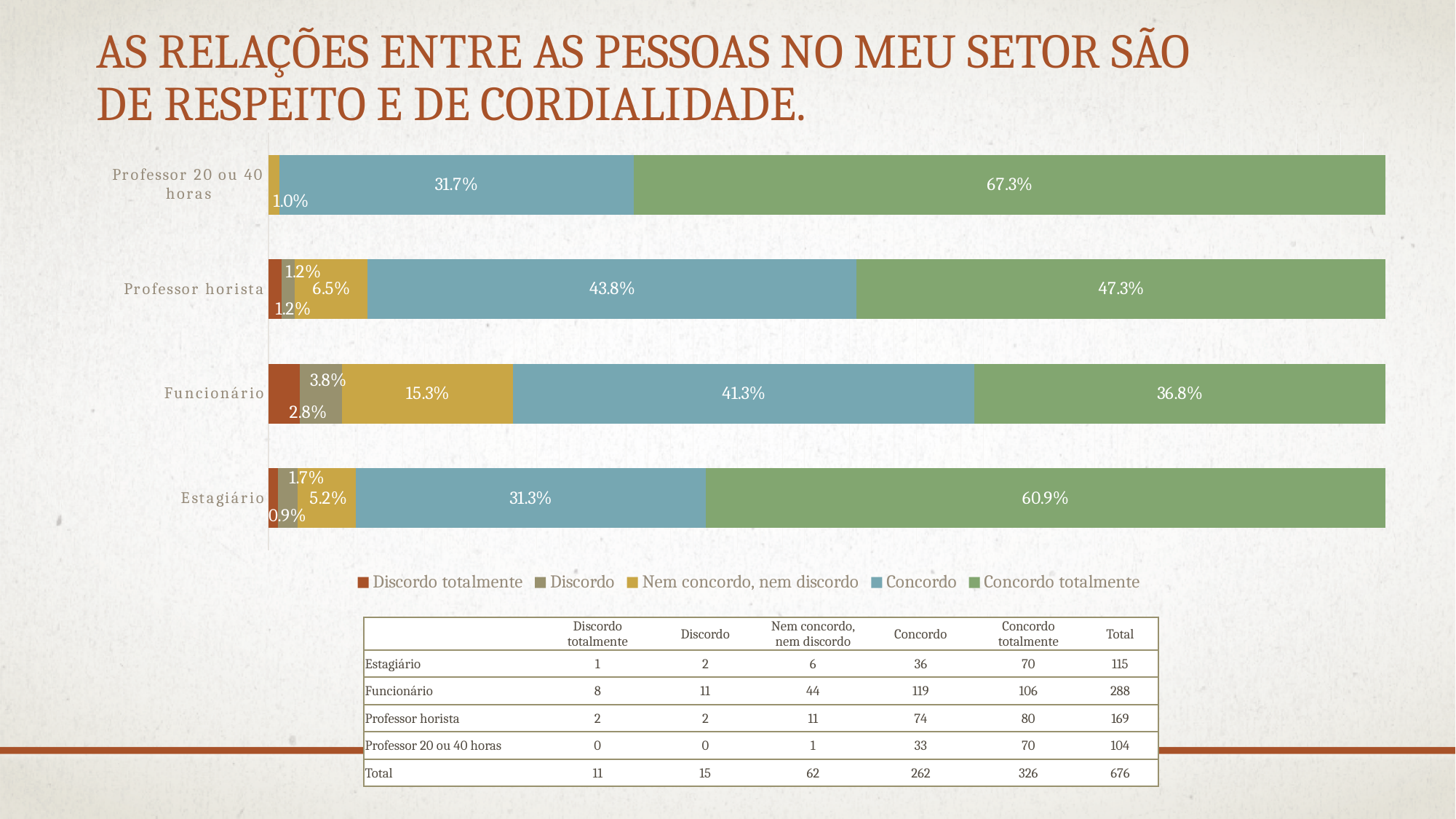
Which category has the highest 'Concordo totalmente' value? Professor 20 ou 40 horas How many categories are plotted on the chart? 4 Which is larger: the 'Concordo' value for Estagiário or for Professor 20 ou 40 horas? Professor 20 ou 40 horas What is the 'Concordo' value for Professor horista? 43.8% What is the 'Concordo totalmente' value for Professor 20 ou 40 horas? 67.3% What kind of chart is shown on the slide? Stacked bar chart Which category has the lowest 'Concordo totalmente' value? Funcionário How many series does the chart legend list? 5 What is the 'Nem concordo, nem discordo' value for Funcionário? 15.3% What is the difference between the 'Concordo' values for Professor horista and Funcionário? 2.5% What is the 'Concordo totalmente' value for Estagiário? 60.9% Which legend entry is shown in green? Concordo totalmente